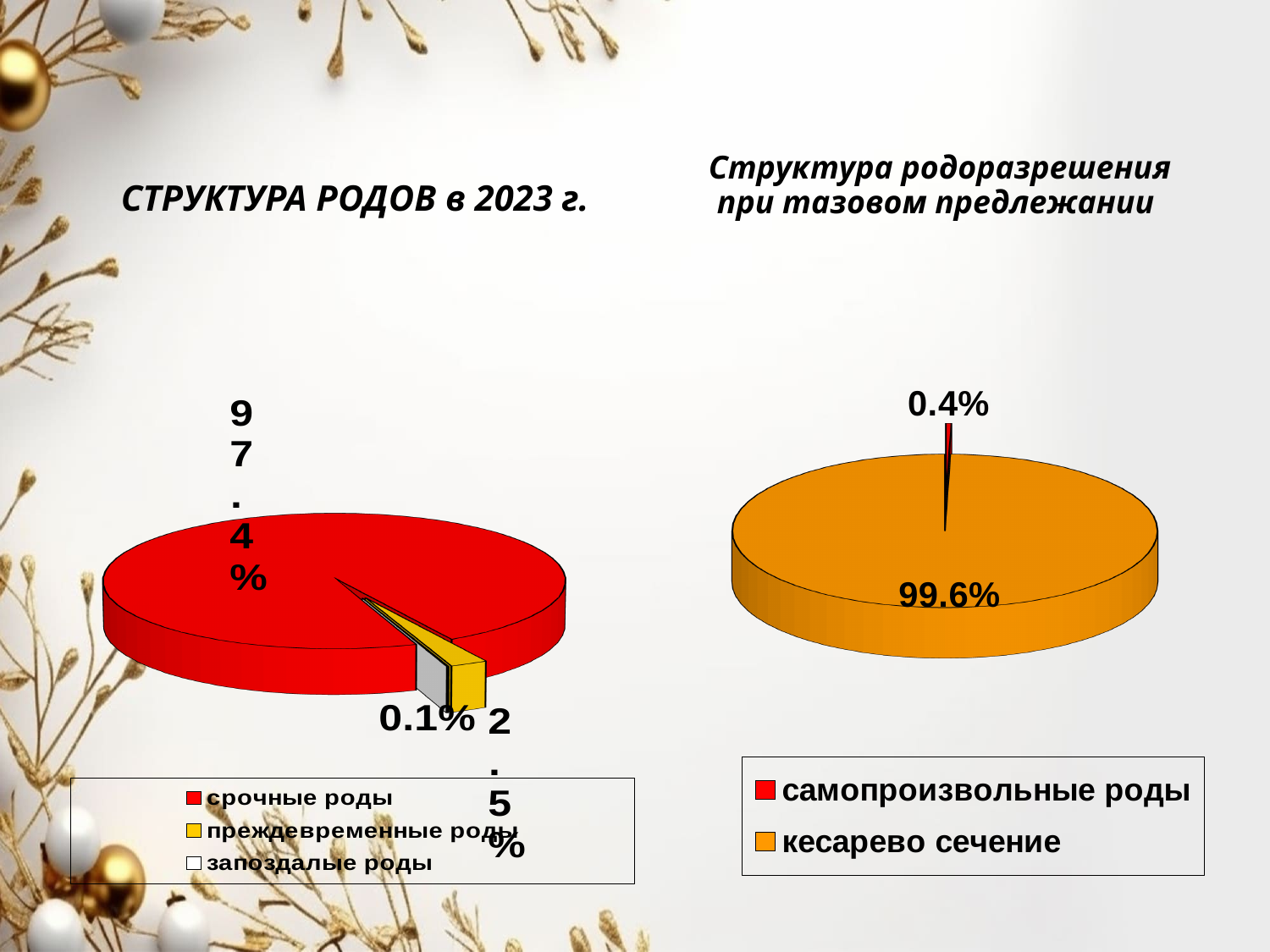
In the chart titled "СТРУКТУРА РОДОВ в 2023 г.", how many categories does the legend list? 3 In the chart titled "Структура родоразрешения при тазовом предлежании", what share is shown for кесарево сечение? 99.6% In the chart titled "Структура родоразрешения при тазовом предлежании", which category has the larger slice? кесарево сечение In the chart titled "СТРУКТУРА РОДОВ в 2023 г.", what share is shown for срочные роды? 97.4% In the chart titled "Структура родоразрешения при тазовом предлежании", what colour is the slice for кесарево сечение? Orange In the chart titled "Структура родоразрешения при тазовом предлежании", what is the difference between the shares for кесарево сечение and самопроизвольные роды? 99.2% In the chart titled "СТРУКТУРА РОДОВ в 2023 г.", which category has the smallest slice? запоздалые роды In the chart titled "Структура родоразрешения при тазовом предлежании", what share is shown for самопроизвольные роды? 0.4% In the chart titled "СТРУКТУРА РОДОВ в 2023 г.", what share is shown for запоздалые роды? 0.1% What kind of chart is the one titled "СТРУКТУРА РОДОВ в 2023 г."? Pie chart In the chart titled "СТРУКТУРА РОДОВ в 2023 г.", what share is shown for преждевременные роды? 2.5% In the chart titled "СТРУКТУРА РОДОВ в 2023 г.", which category has the largest slice? срочные роды